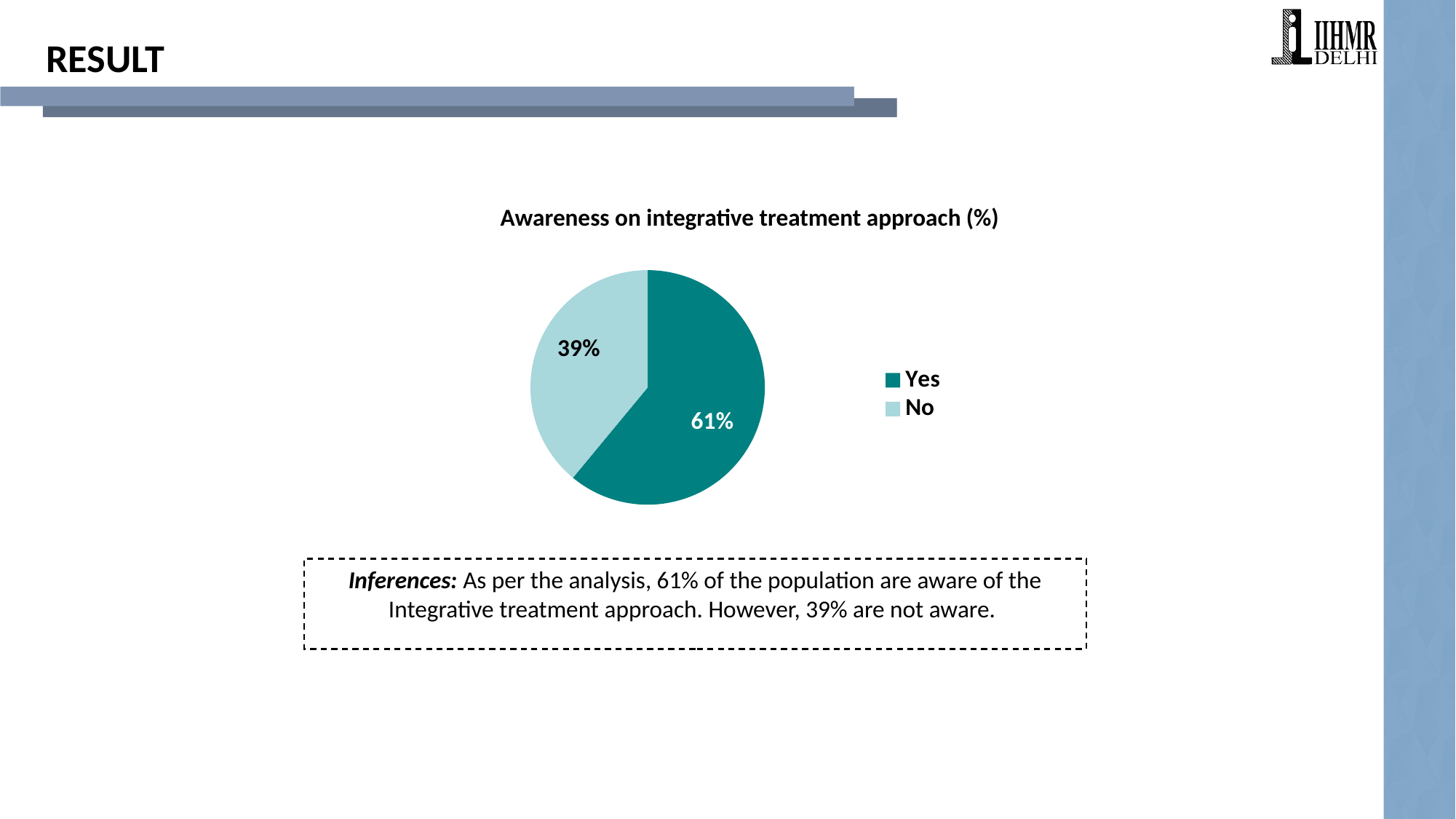
What percentage of the pie chart is labelled "No"? 39% How many entries does the legend list? 2 What kind of chart is shown on the slide? Pie chart What percentage of the pie chart is labelled "Yes"? 61% Which slice of the pie chart is the largest? Yes Which legend entry is shown in the lighter colour? No How many slices does the pie chart have? 2 What is the difference in percentage points between the "Yes" and "No" slices? 22 Which slice is larger, "Yes" or "No"? Yes What share of the pie does the "No" slice represent? 39% What is the title of the chart? Awareness on integrative treatment approach (%) Which slice of the pie chart is the smallest? No